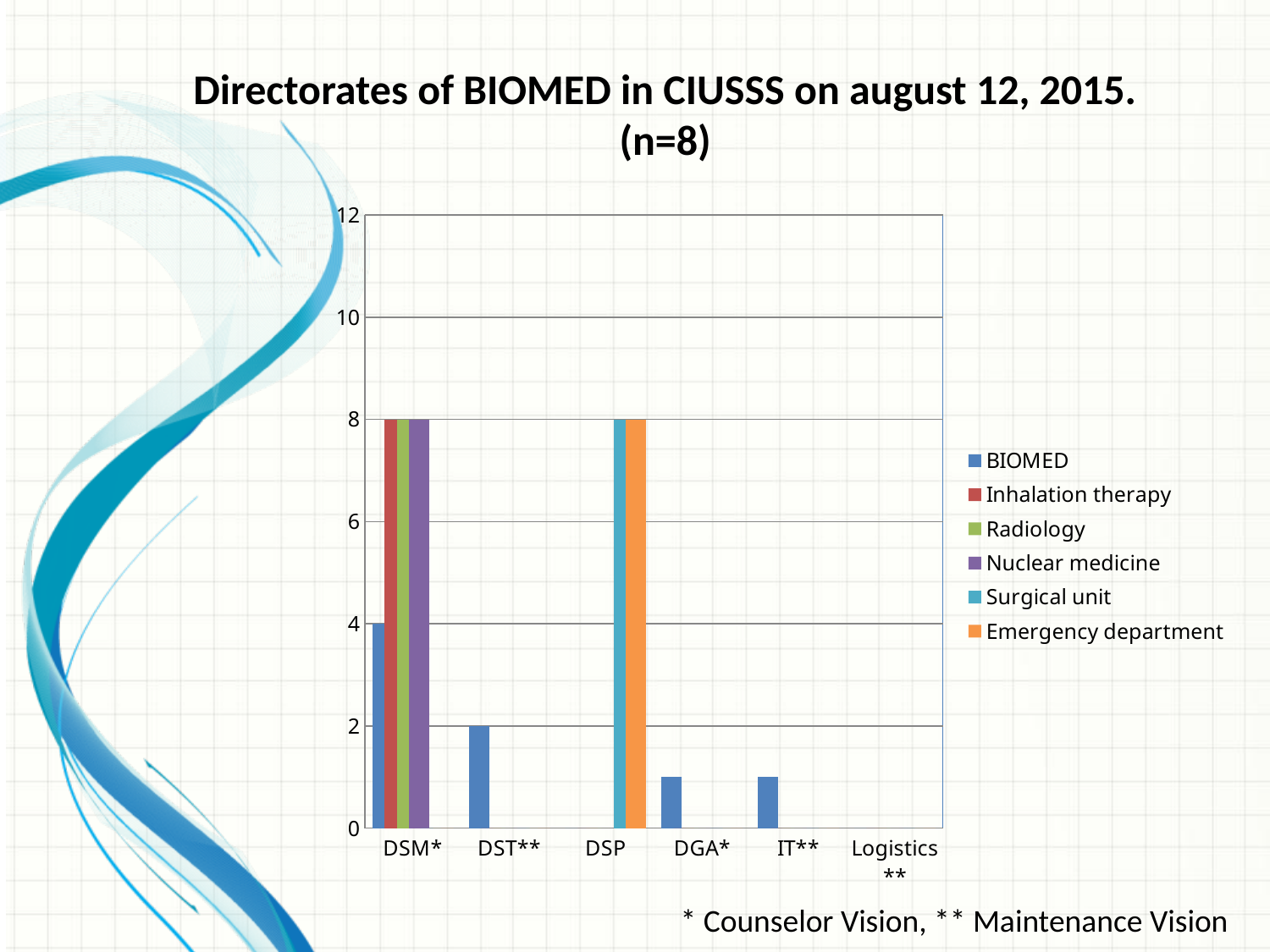
Which has the larger BIOMED value, DSM* or DST**? DSM* What is the Surgical unit value for DSP? 8 How many series does the legend list? 6 What is the BIOMED value for DSM*? 4 What is the BIOMED value for DST**? 2 How many categories are shown on the x axis? 6 What kind of chart is shown on the slide? bar chart Which category has the highest BIOMED value? DSM* What is the Inhalation therapy value for DSM*? 8 What is the difference between the BIOMED values for DSM* and DST**? 2 What is the title of the chart? Directorates of BIOMED in CIUSSS on august 12, 2015. (n=8) Is the BIOMED value for DGA* greater or less than 2? less